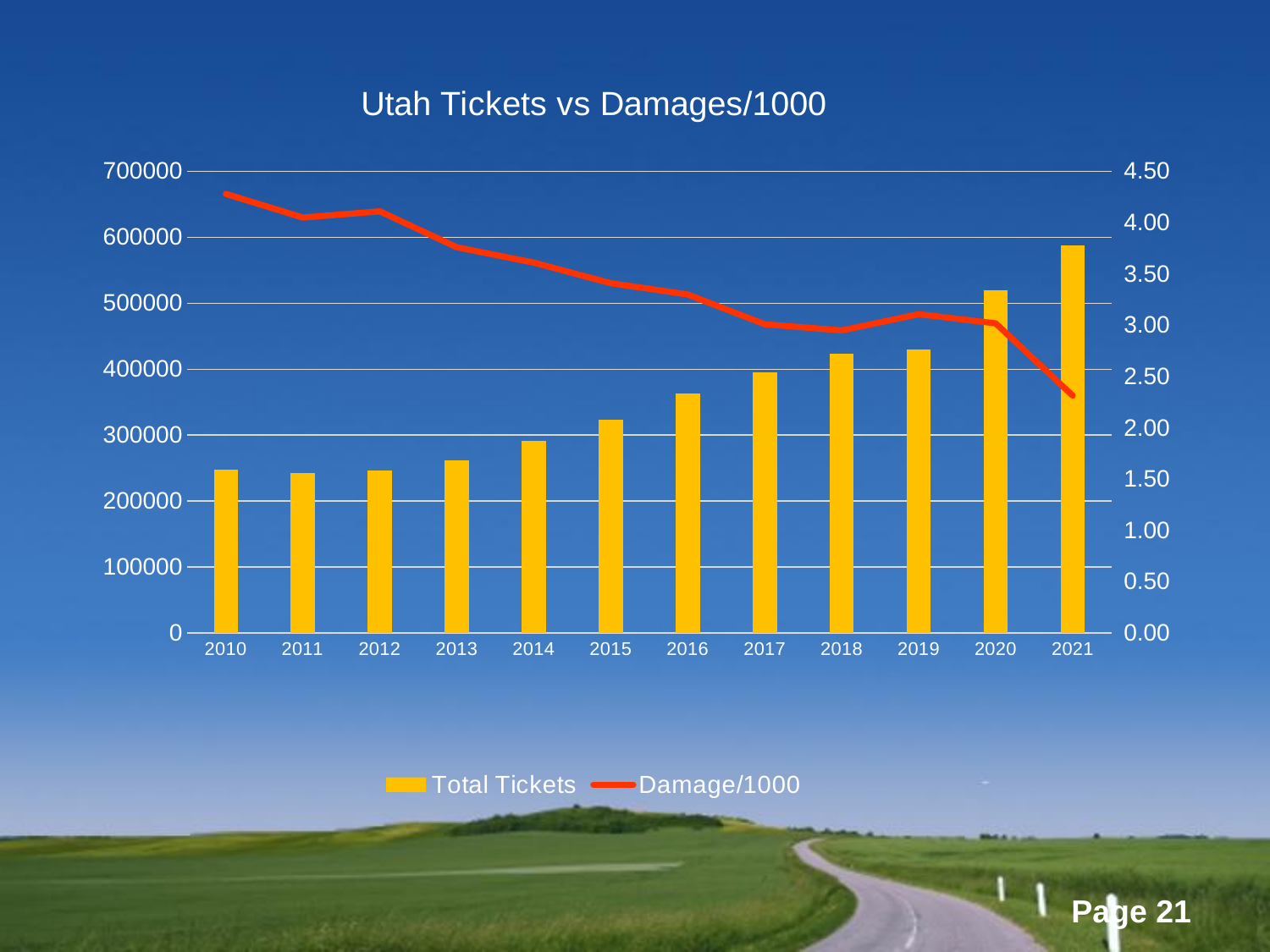
Is the Total Tickets value for 2021 greater or less than 500000? greater Which year has the larger Total Tickets value, 2019 or 2020? 2020 In which year is the Damage/1000 line at its highest? 2010 How many years are shown on the x axis? 12 In which year is the Damage/1000 line at its lowest? 2021 What is the title of the chart? Utah Tickets vs Damages/1000 Which year has the highest Total Tickets bar? 2021 What kind of chart is this? Combined bar and line chart Does the Damage/1000 line generally rise or fall from 2010 to 2021? fall Is the Damage/1000 value for 2021 greater or less than 2.50? less How many series does the legend list? 2